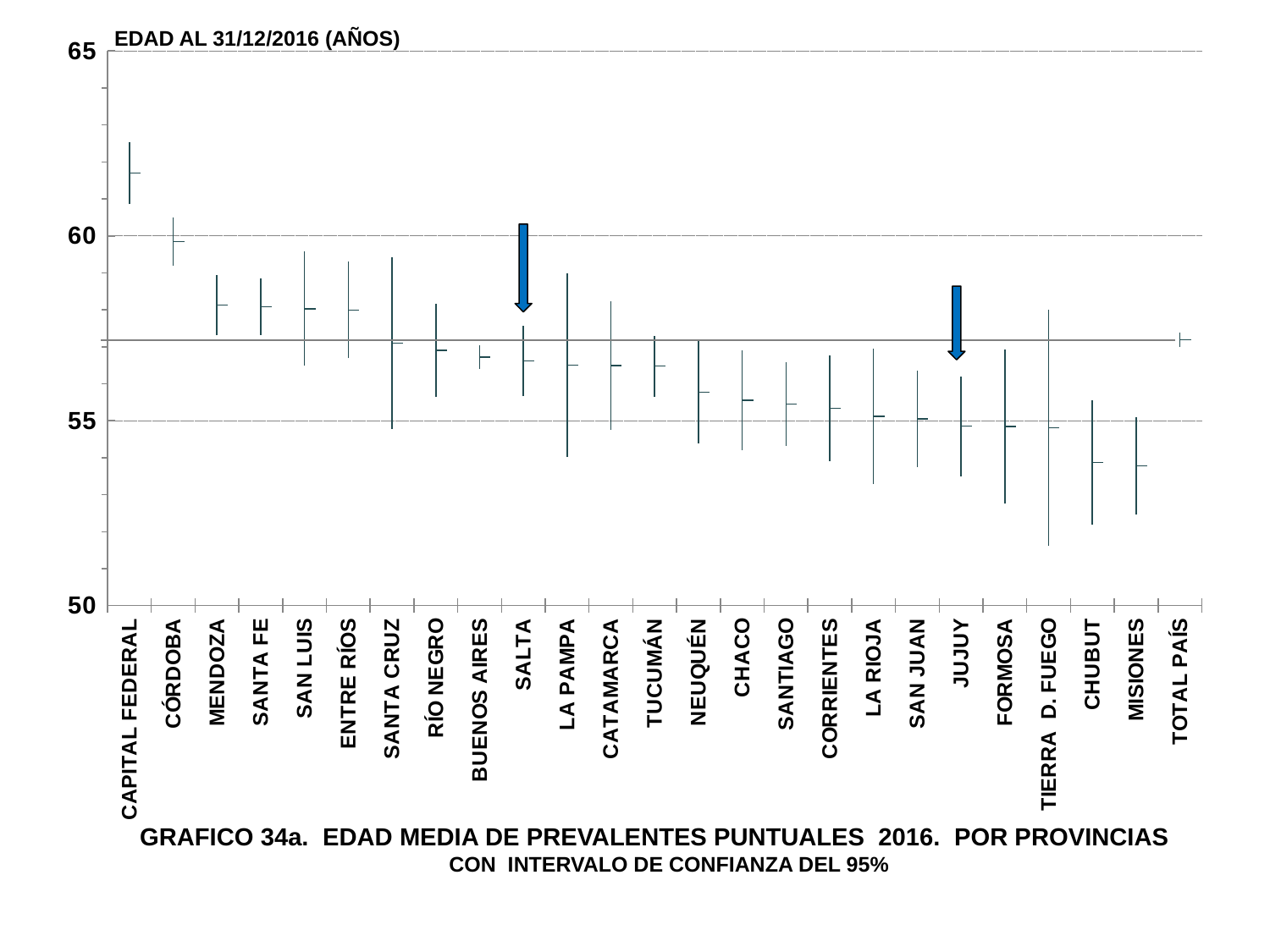
Which has a higher mean age, CÓRDOBA or CHACO? CÓRDOBA Which has a higher mean age, CAPITAL FEDERAL or MISIONES? CAPITAL FEDERAL Do the mean ages generally rise or fall from left to right across the provinces? fall What is the title of the vertical axis? EDAD AL 31/12/2016 (AÑOS) Is the mean age for CAPITAL FEDERAL greater or less than 60? greater How many categories are shown along the x axis, including TOTAL PAÍS? 25 What confidence interval level does the chart subtitle say is shown? 95% Is the mean age for MISIONES greater or less than 55? less Is the mean age for SANTA FE greater or less than 55? greater Which province has the highest mean age in the chart? CAPITAL FEDERAL